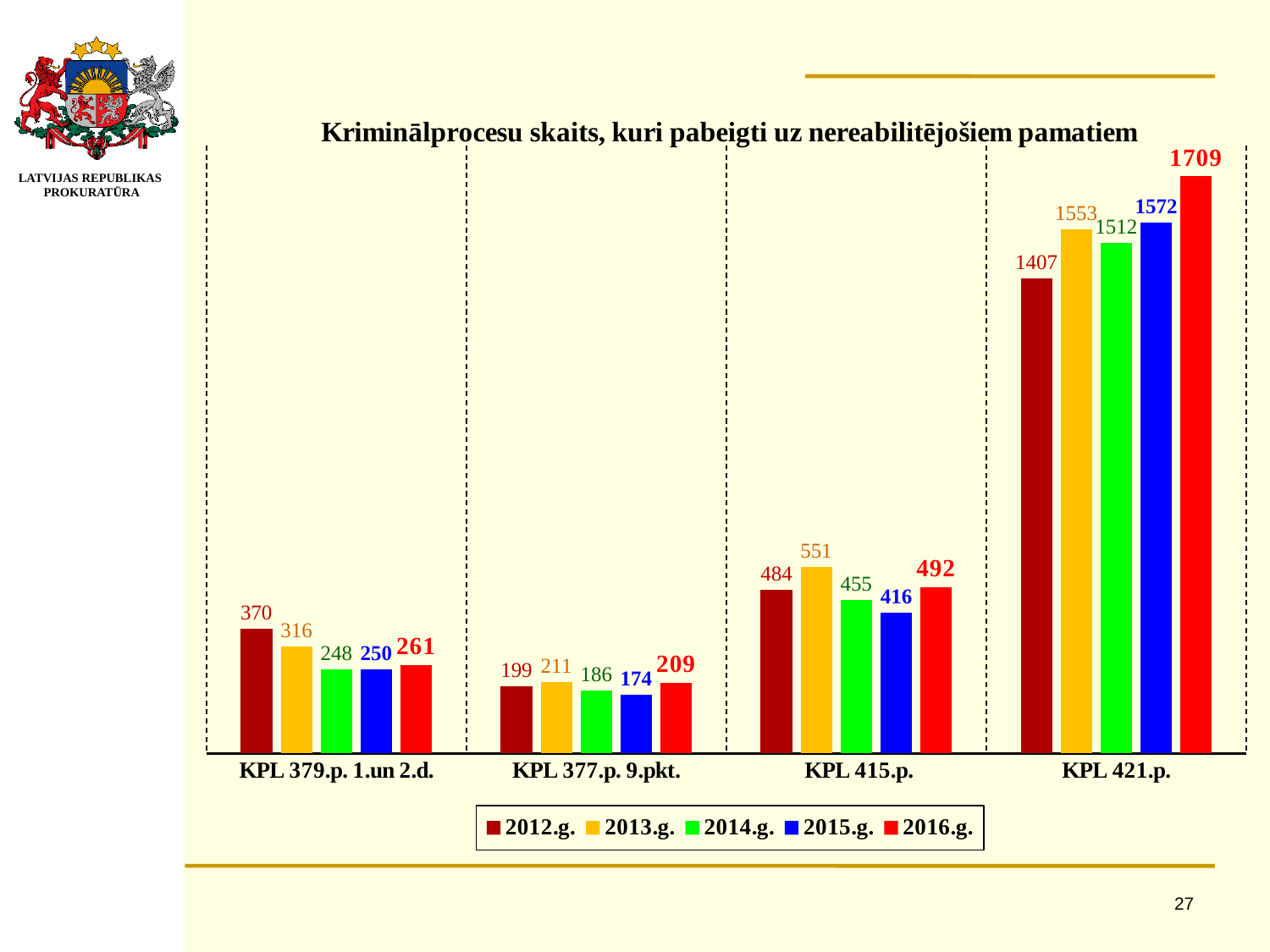
How many series does the legend list? 5 What is the difference between the 2016.g. and 2012.g. values in the KPL 421.p. category? 302 Which year has the lowest value in the KPL 377.p. 9.pkt. category? 2015.g. How many categories are shown on the x axis? 4 Which is larger in the KPL 415.p. category: the 2014.g. value or the 2015.g. value? 2014.g. What kind of chart is shown on the slide? bar chart What is the value for 2012.g. in the KPL 379.p. 1.un 2.d. category? 370 What is the value for 2016.g. in the KPL 421.p. category? 1709 What is the value for 2015.g. in the KPL 377.p. 9.pkt. category? 174 Which year has the highest value in the KPL 421.p. category? 2016.g. What is the value for 2013.g. in the KPL 415.p. category? 551 What is the title of the chart? Kriminālprocesu skaits, kuri pabeigti uz nereabilitējošiem pamatiem